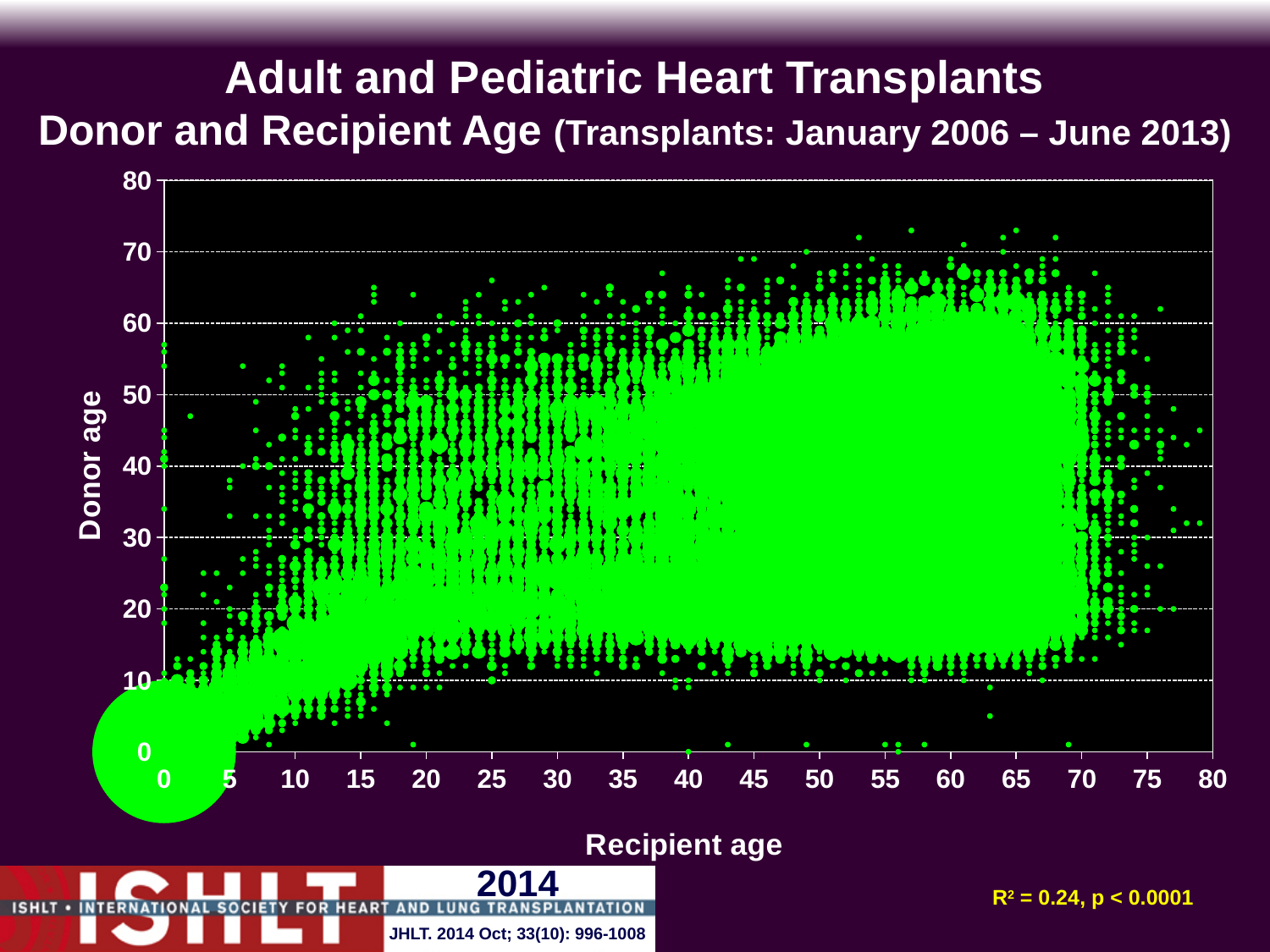
What is the label of the y axis? Donor age What is the highest value shown on the y axis? 80 What is the highest value shown on the x axis? 80 What is the label of the x axis? Recipient age What R² value is reported on the slide? 0.24 What p-value is reported on the slide? p < 0.0001 Does donor age generally rise or fall as recipient age increases along the x axis? rise What kind of chart is shown on the slide? bubble chart